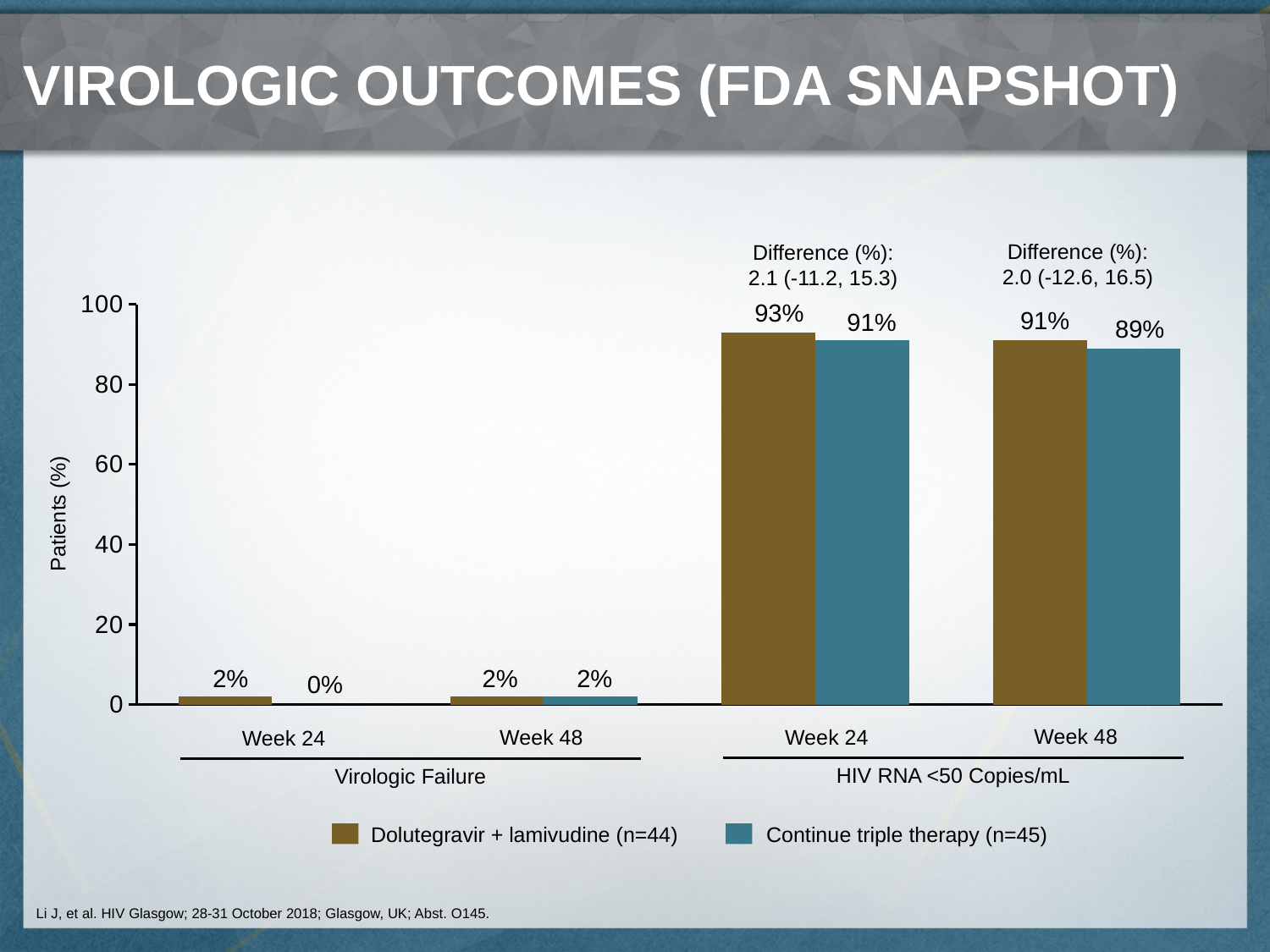
Which bar has the highest value on the chart? Dolutegravir + lamivudine, Week 24, HIV RNA <50 Copies/mL What is the value for Continue triple therapy at Week 24 for Virologic Failure? 0% Is the value for Continue triple therapy at Week 48 for HIV RNA <50 Copies/mL greater or less than 80? greater How many series does the legend list? 2 What is the difference between the Dolutegravir + lamivudine and Continue triple therapy values at Week 48 for HIV RNA <50 Copies/mL? 2% What is the value for Dolutegravir + lamivudine at Week 48 for Virologic Failure? 2% What kind of chart is shown on the slide? Bar chart Which is larger at Week 24 for HIV RNA <50 Copies/mL: Dolutegravir + lamivudine or Continue triple therapy? Dolutegravir + lamivudine What is the title of the slide? VIROLOGIC OUTCOMES (FDA SNAPSHOT) What is the label of the y axis? Patients (%) What is the value for Dolutegravir + lamivudine at Week 24 for HIV RNA <50 Copies/mL? 93% What is the value for Continue triple therapy at Week 48 for HIV RNA <50 Copies/mL? 89%